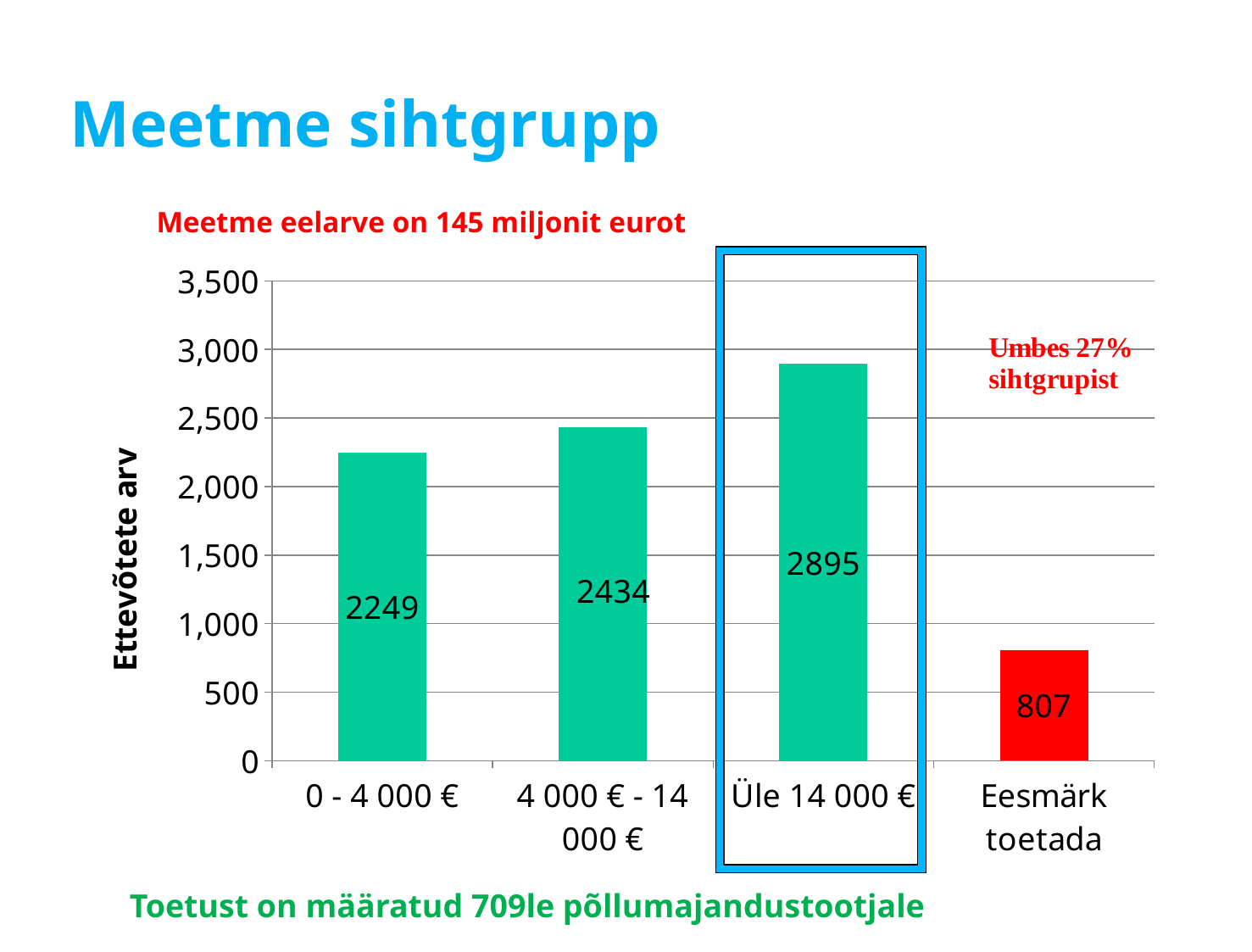
How many bars are shown in the chart? 4 What is the difference between the values for "4 000 € - 14 000 €" and "Eesmärk toetada"? 1627 Which is larger, the value for "4 000 € - 14 000 €" or the value for "0 - 4 000 €"? 4 000 € - 14 000 € Is the value for "Eesmärk toetada" greater or less than 1,000? less What is the value for the "Üle 14 000 €" category? 2895 What is the value for the "0 - 4 000 €" category? 2249 What is the value for "Eesmärk toetada"? 807 Which category has the highest value? Üle 14 000 € What is the difference between the values for "Üle 14 000 €" and "0 - 4 000 €"? 646 What kind of chart is shown on the slide? bar chart What is the label of the vertical axis? Ettevõtete arv Which category has the lowest value? Eesmärk toetada